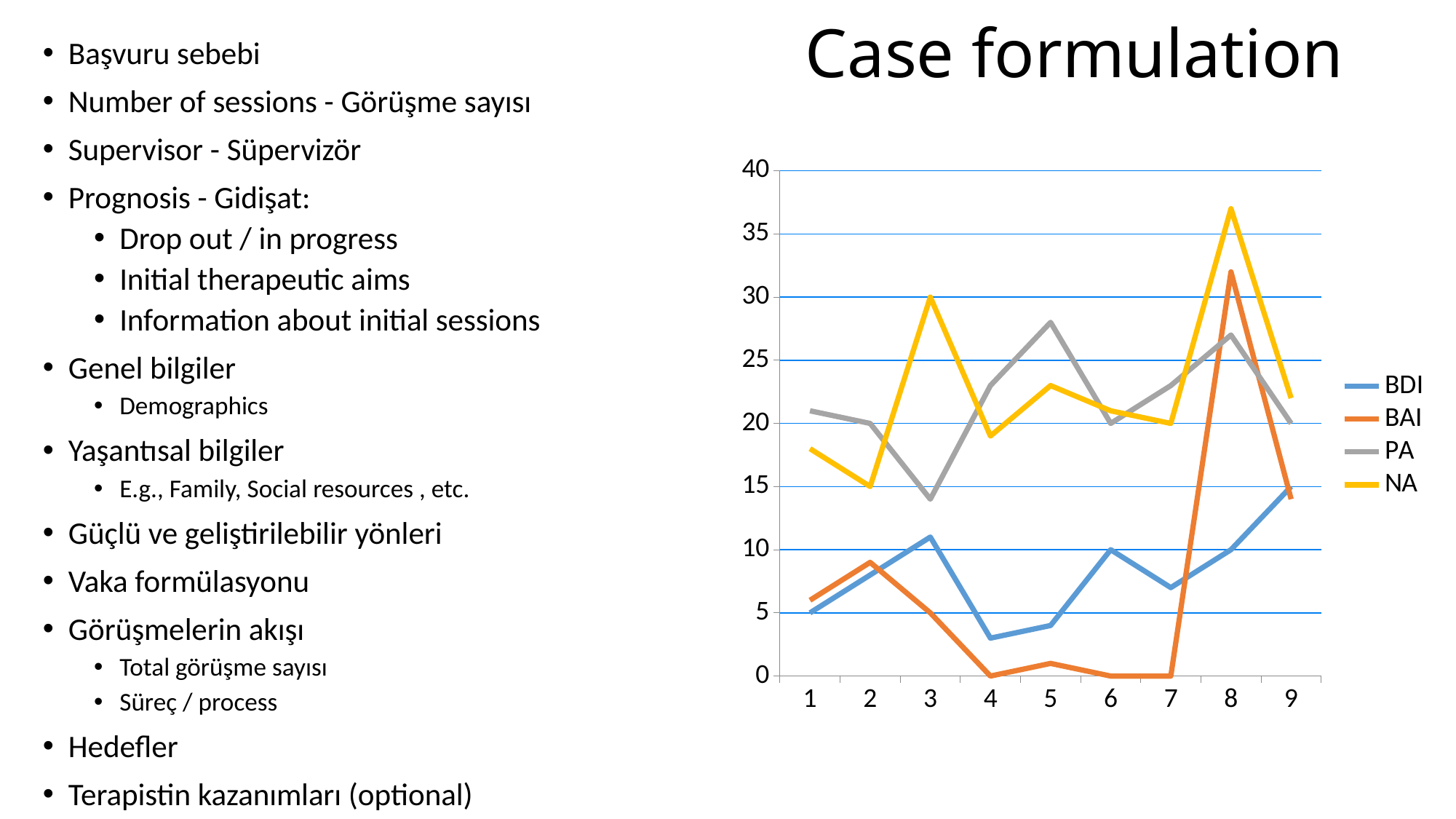
What is the value of BAI at point 7? 0 Does the BDI line rise or fall from point 7 to point 9? rise Is the value of BAI at point 8 greater or less than 30? greater Which series reaches the highest value on the chart? NA At point 5, which is larger, PA or NA? PA Is the value of NA at point 8 greater or less than 35? greater What kind of chart is shown on the slide? line chart How many points are on the x axis of the chart? 9 Is the value of BDI at point 4 greater or less than 5? less What is the value of BAI at point 4? 0 What is the value of NA at point 3? 30 How many series does the chart legend list? 4